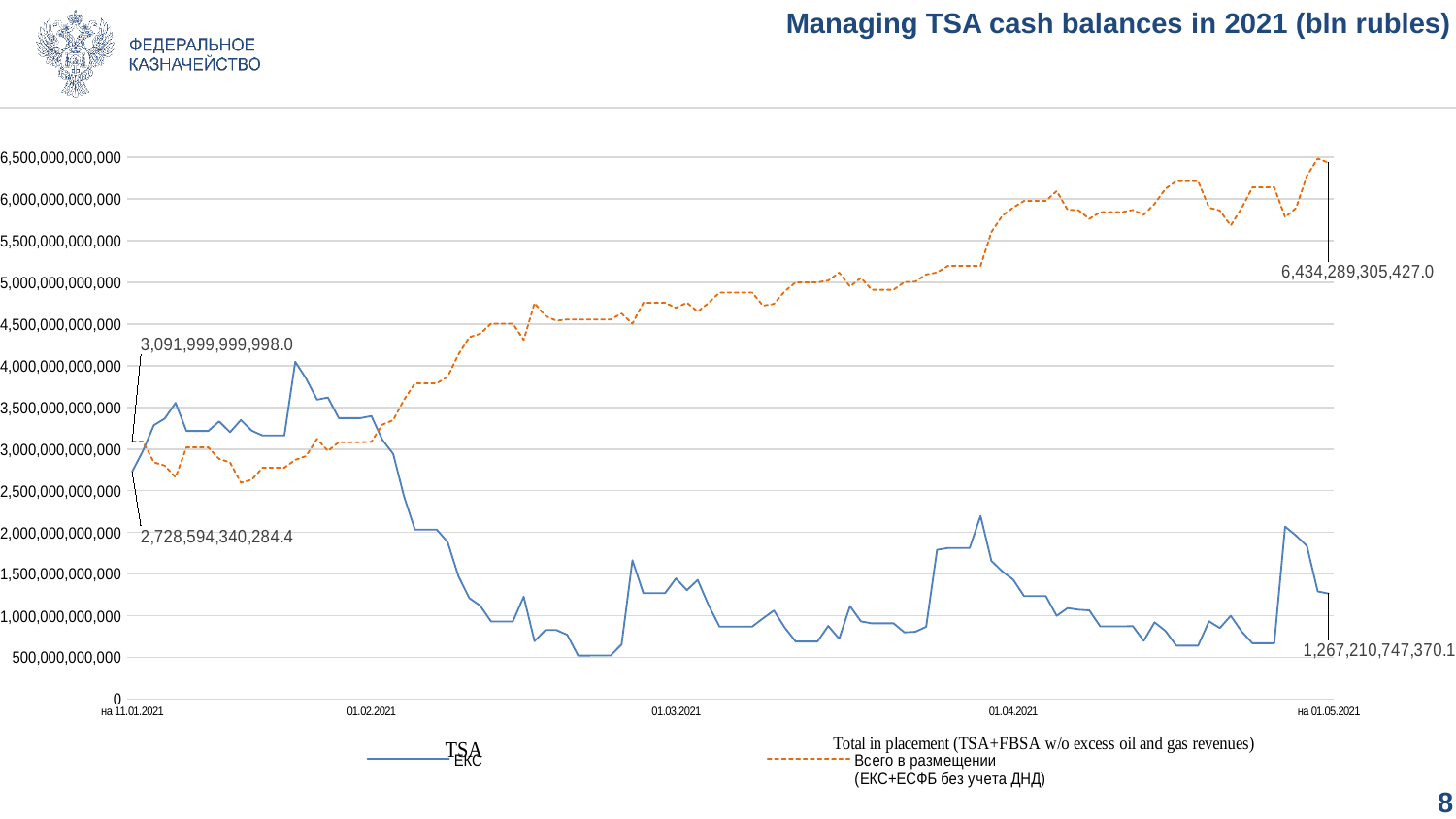
What is the value of the Total in placement series at the end of the chart (на 01.05.2021)? 6,434,289,305,427.0 What is the value of the Total in placement series at the start of the chart (на 11.01.2021)? 3,091,999,999,998.0 What is the difference between the Total in placement and TSA values at the end of the chart (на 01.05.2021)? 5,167,078,558,056.9 Is the value of the Total in placement series at 01.04.2021 greater or less than 5,000,000,000,000? greater What is the value of the TSA series at the start of the chart (на 11.01.2021)? 2,728,594,340,284.4 Does the Total in placement series rise or fall overall from 11.01.2021 to 01.05.2021? Rise What kind of chart is shown on the slide? Line chart Which series has the larger value at the end of the chart (на 01.05.2021), TSA or Total in placement? Total in placement What is the title of the chart on the slide? Managing TSA cash balances in 2021 (bln rubles) What is the difference between the Total in placement and TSA values at the start of the chart (на 11.01.2021)? 363,405,659,713.6 What is the value of the TSA series at the end of the chart (на 01.05.2021)? 1,267,210,747,370.1 How many series does the chart's legend list? 2